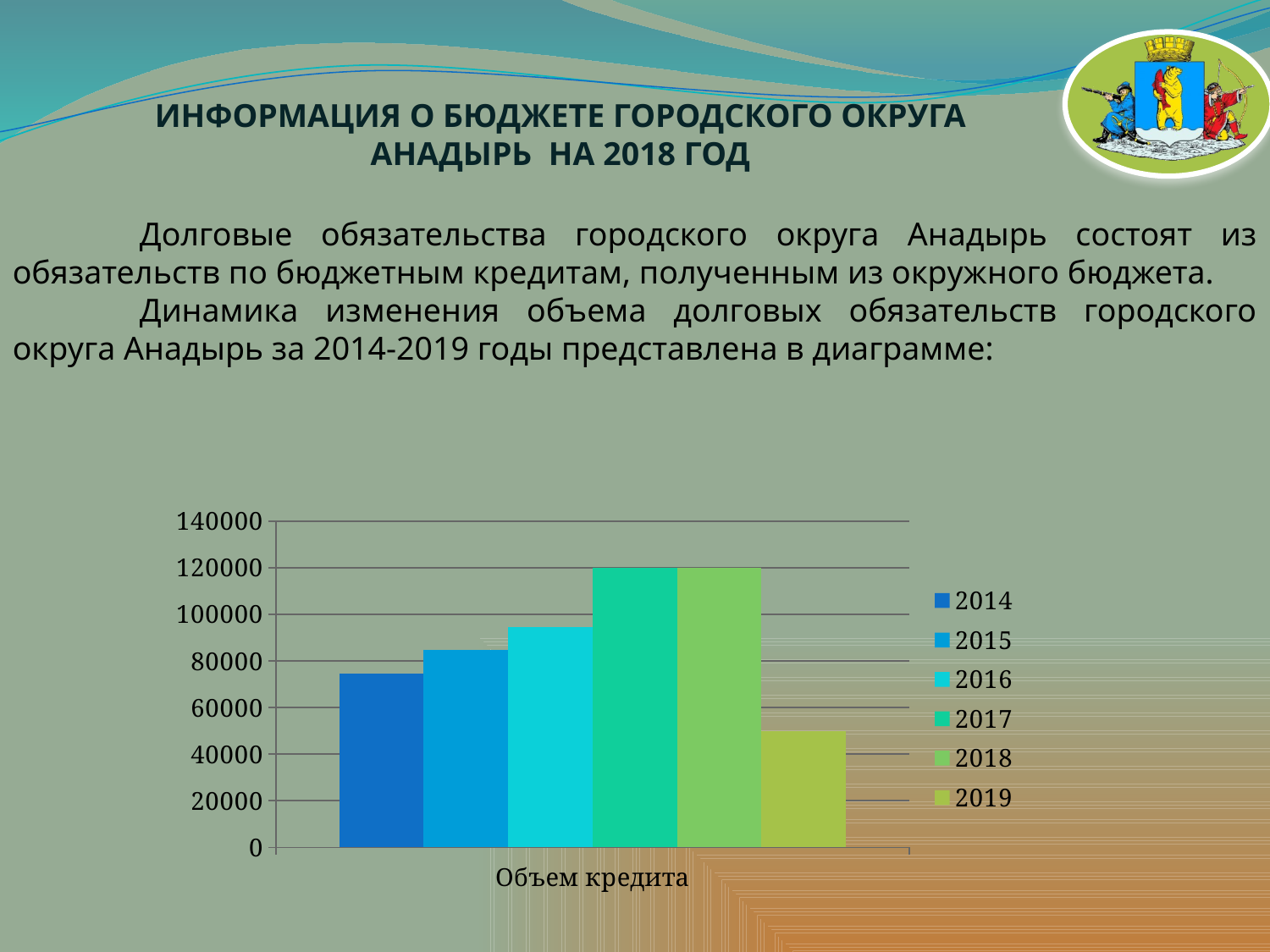
How many series does the legend list? 6 Is the value for 2018 greater or less than 100000? greater Is the value for 2014 greater or less than 80000? less How many categories are shown on the x axis? 1 Is the value for 2016 greater or less than 80000? greater What kind of chart is shown on the slide? bar chart Which year is listed first in the legend? 2014 Which is larger, the value for 2019 or the value for 2015? 2015 What is the label of the category on the x axis? Объем кредита Which year has the lowest value in the chart? 2019 Which is larger, the value for 2014 or the value for 2016? 2016